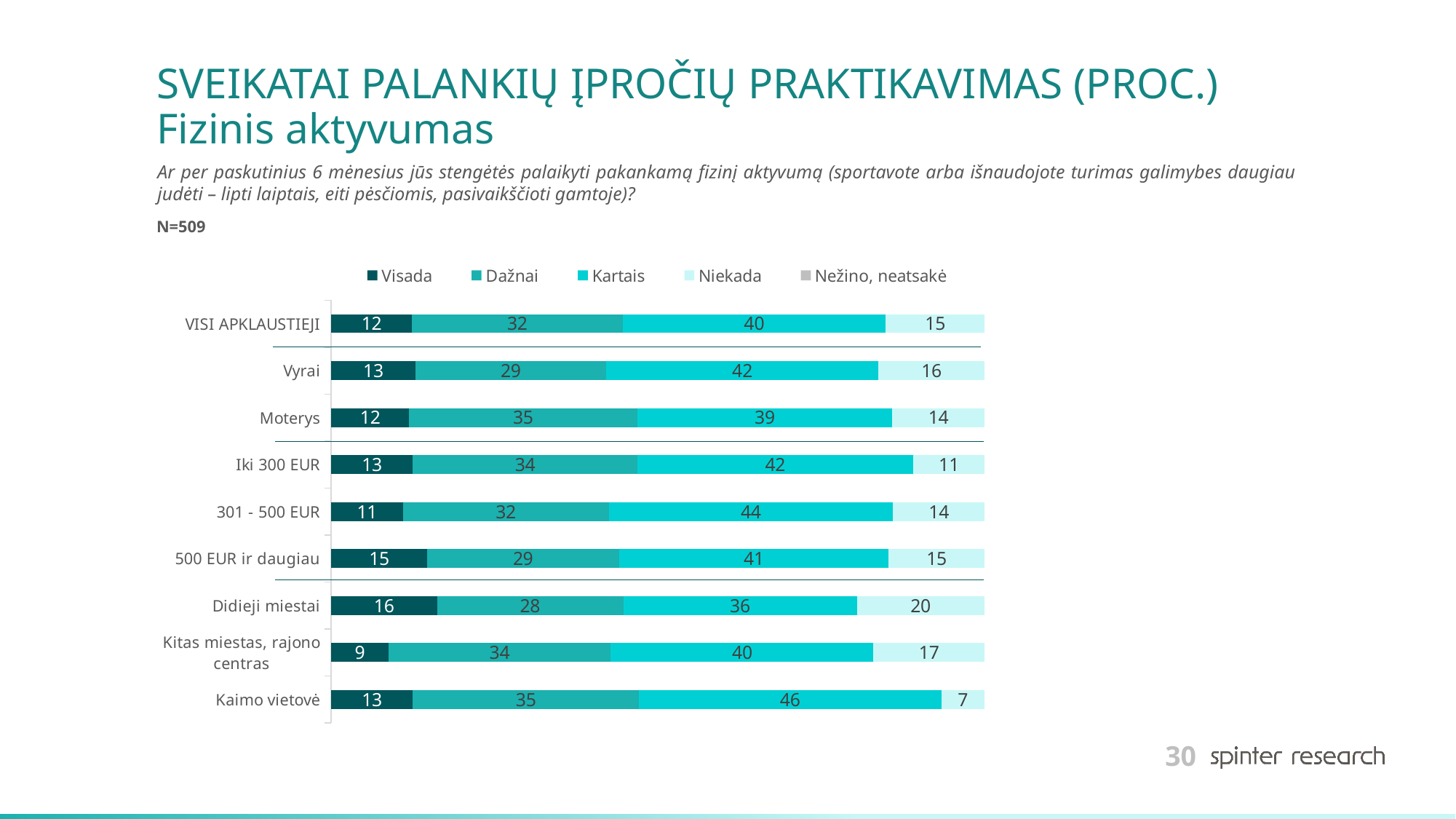
How many series does the legend list? 5 What is the 'Niekada' value for 'Didieji miestai'? 20 What kind of chart is shown on the slide? stacked bar chart Which category has the lowest 'Visada' value? Kitas miestas, rajono centras Which category has the lowest 'Niekada' value? Kaimo vietovė Which category has the highest 'Visada' value? Didieji miestai How many categories (respondent groups) are shown on the chart? 9 What is the first series listed in the legend? Visada What is the difference between the 'Kartais' values for 'Vyrai' and 'Moterys'? 3 What is the 'Kartais' value for 'Kaimo vietovė'? 46 Which is larger: the 'Dažnai' value for 'Moterys' or for 'Vyrai'? Moterys What is the 'Visada' value for 'VISI APKLAUSTIEJI'? 12